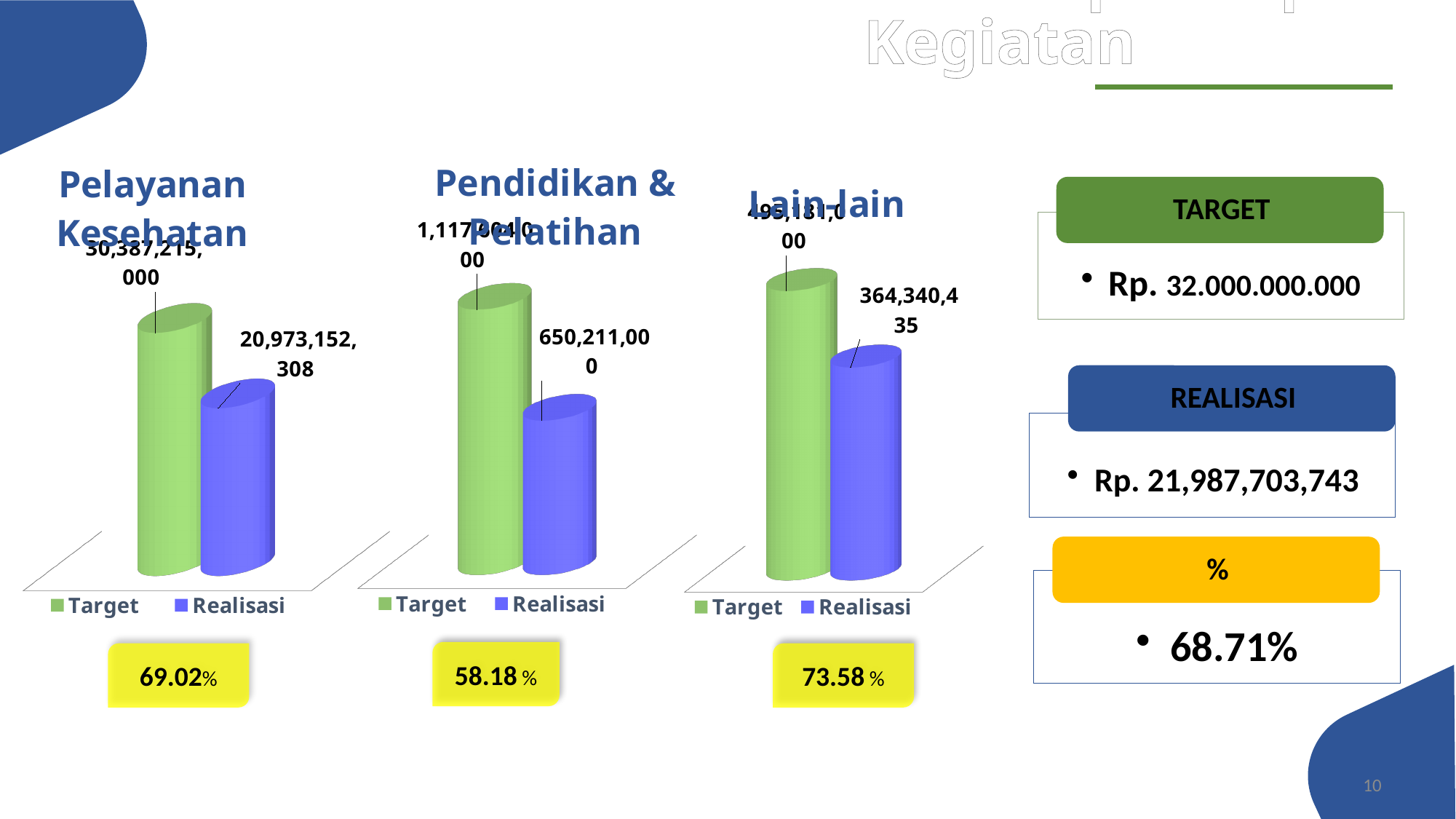
In the Pendidikan & Pelatihan chart, what is the value of the Realisasi bar? 650,211,000 How many series does the legend of the Lain-lain chart list? 2 What type of chart is the Pendidikan & Pelatihan chart? Bar chart In the Lain-lain chart, which series has the higher value? Target How many bars are plotted in the Lain-lain chart? 2 In the Pelayanan Kesehatan chart, what colour is the Realisasi bar? Blue In the Pelayanan Kesehatan chart, what is the value of the Target bar? 30,387,215,000 In the Pelayanan Kesehatan chart, which bar is taller, Target or Realisasi? Target In the Pelayanan Kesehatan chart, what is the difference between the Target and Realisasi values? 9,414,062,692 In the Lain-lain chart, what is the value of the Realisasi bar? 364,340,435 In the Pendidikan & Pelatihan chart, which series has the lower value? Realisasi In the Pelayanan Kesehatan chart, what is the value of the Realisasi bar? 20,973,152,308